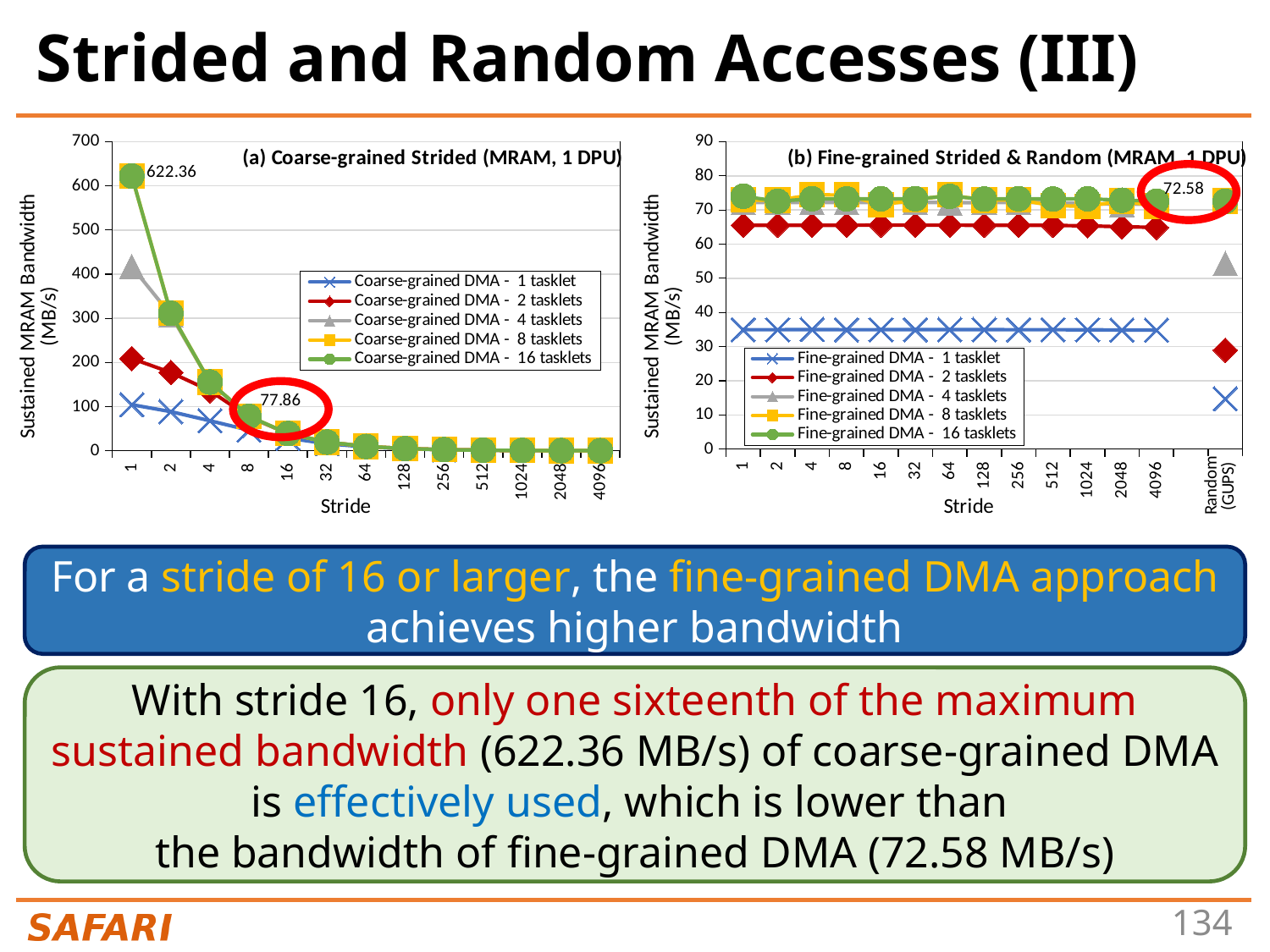
What kind of chart is chart (a) Coarse-grained Strided (MRAM, 1 DPU)? line chart In chart (a) Coarse-grained Strided (MRAM, 1 DPU), what is the labeled value at stride 1? 622.36 In chart (a) Coarse-grained Strided (MRAM, 1 DPU), how many stride values are shown on the x axis? 13 In chart (a) Coarse-grained Strided (MRAM, 1 DPU), what is the difference between the labeled values at stride 1 and stride 16? 544.5 In chart (a) Coarse-grained Strided (MRAM, 1 DPU), do the bandwidth values rise or fall as the stride increases? fall In chart (b) Fine-grained Strided & Random (MRAM, 1 DPU), how many series does the legend list? 5 In chart (b) Fine-grained Strided & Random (MRAM, 1 DPU), is the value for Fine-grained DMA - 1 tasklet at stride 1 greater or less than 40? less In chart (b) Fine-grained Strided & Random (MRAM, 1 DPU), how many categories are shown on the x axis? 14 In chart (a) Coarse-grained Strided (MRAM, 1 DPU), what is the labeled value at stride 16? 77.86 In chart (b) Fine-grained Strided & Random (MRAM, 1 DPU), which series has the lowest values across the strides? Fine-grained DMA - 1 tasklet In chart (b) Fine-grained Strided & Random (MRAM, 1 DPU), what is the labeled value for Random (GUPS)? 72.58 In chart (a) Coarse-grained Strided (MRAM, 1 DPU), how many series does the legend list? 5